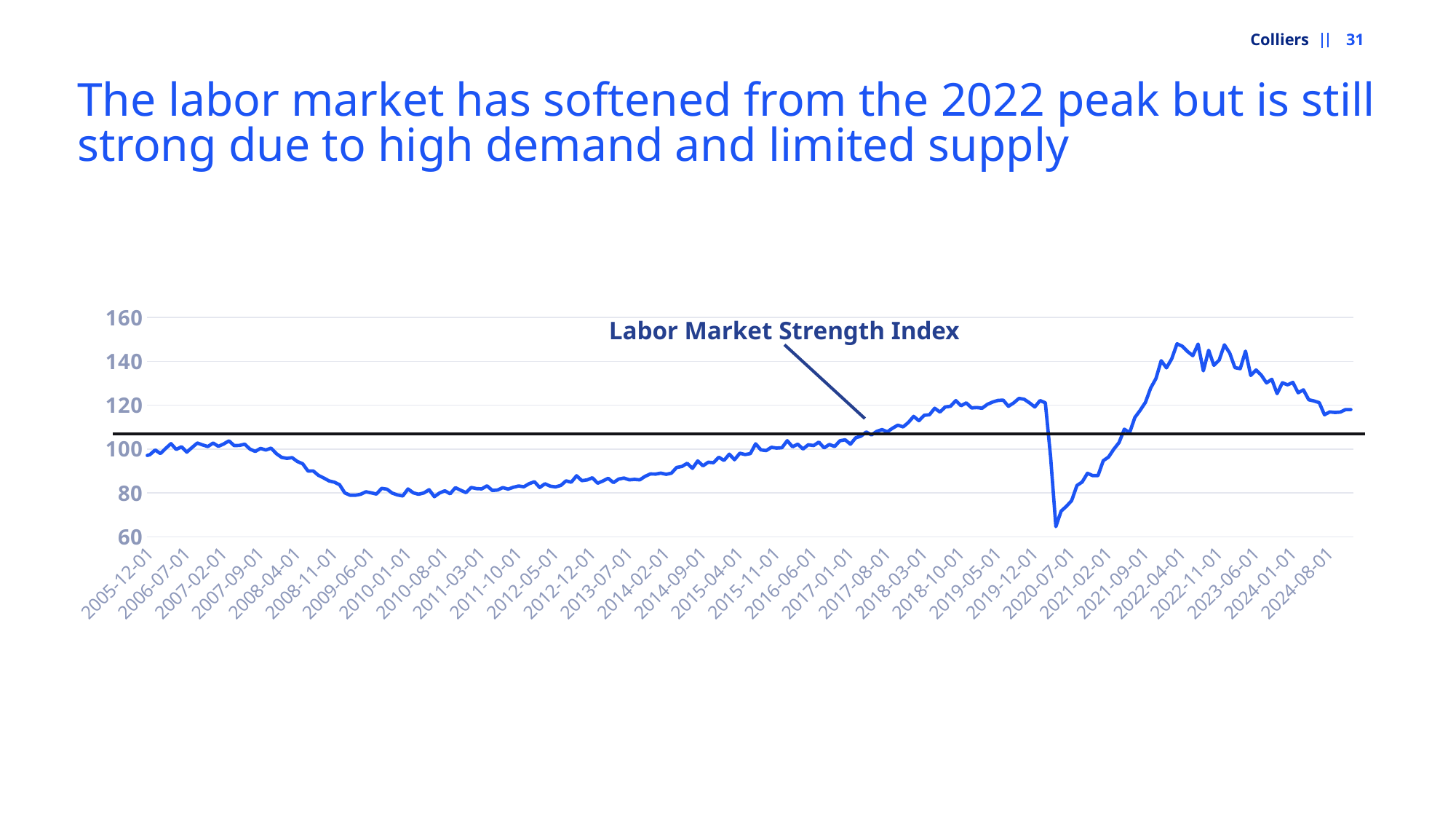
Is the value of the Labor Market Strength Index at 2024-08-01 greater or less than 100? greater Is the value of the Labor Market Strength Index at 2018-10-01 greater or less than 100? greater Is the value of the Labor Market Strength Index at 2020-07-01 greater or less than 80? less Does the Labor Market Strength Index rise or fall between 2020-07-01 and 2022-04-01? rise In which year does the Labor Market Strength Index reach its lowest point? 2020 What is the first date label on the x axis? 2005-12-01 What kind of chart is shown on the slide? line chart In which year does the Labor Market Strength Index reach its highest point? 2022 What is the name of the index plotted on the chart? Labor Market Strength Index Does the Labor Market Strength Index rise or fall between 2022-11-01 and 2024-08-01? fall